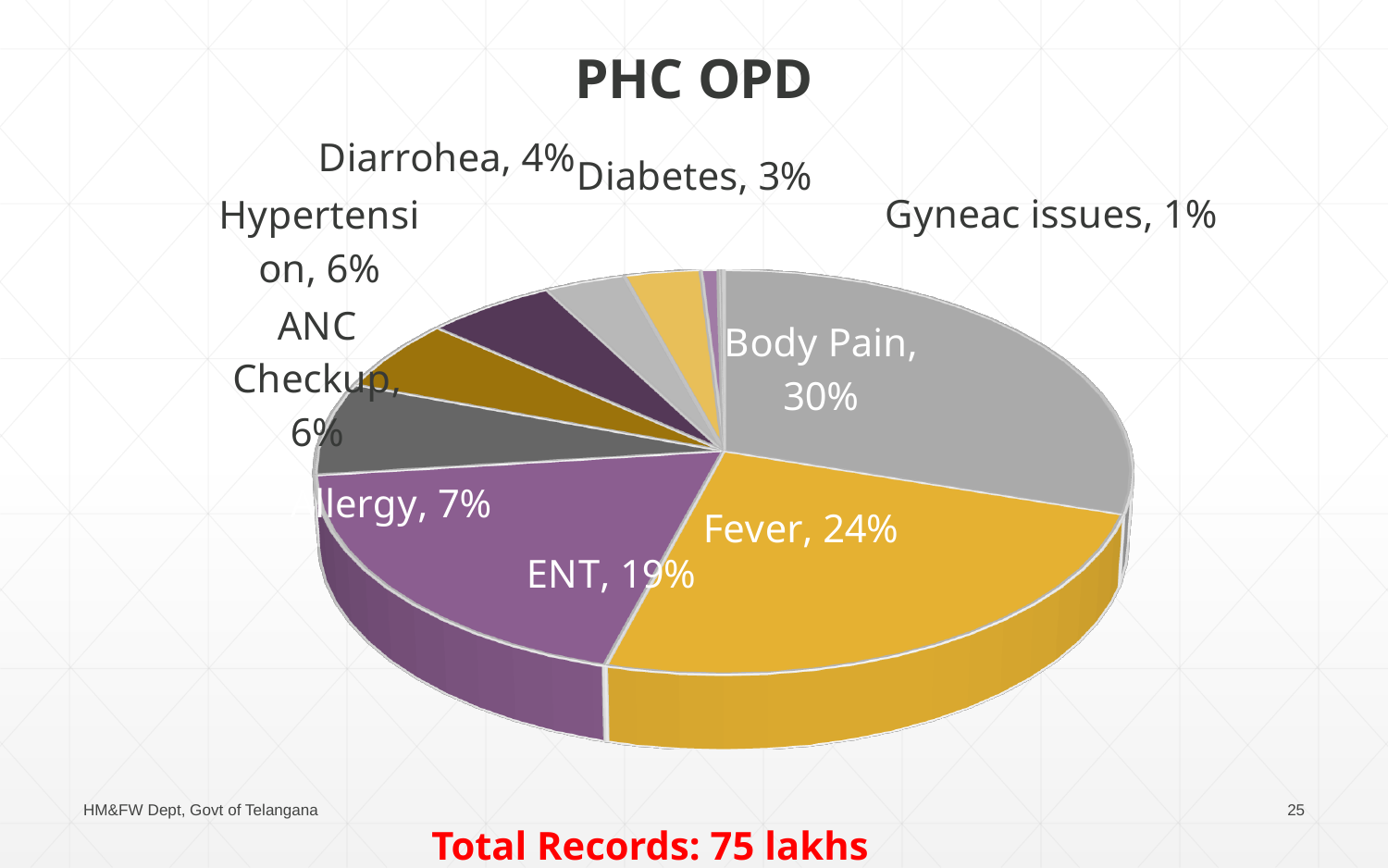
What share of the pie does Body Pain account for? 30% What kind of chart is shown on the slide? pie chart Which category has the largest slice of the pie? Body Pain Which is larger, the share for Allergy or the share for Diabetes? Allergy What is the difference between the ENT and Hypertension shares? 13% What is the value shown for ENT? 19% What is the title of the chart? PHC OPD What is the difference between the Body Pain and Fever shares? 6% What is the value shown for Fever? 24% What is the value shown for Diarrohea? 4%